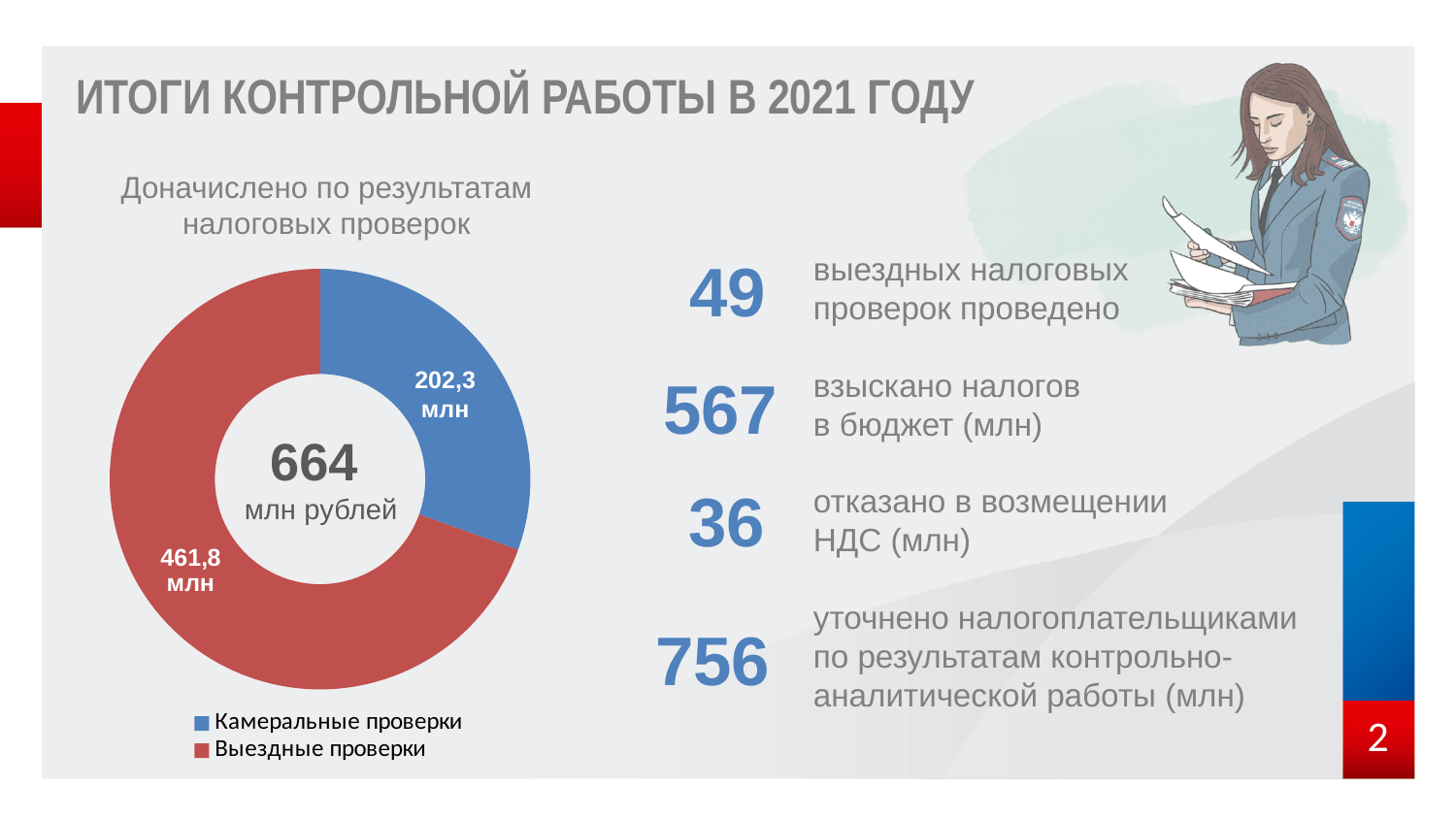
What colour represents Выездные проверки in the chart? Red What value is shown for Камеральные проверки in the chart? 202,3 млн What total is shown in the centre of the donut chart? 664 млн рублей Which is larger in the chart: Камеральные проверки or Выездные проверки? Выездные проверки How many entries does the chart legend list? 2 How many categories does the chart show? 2 Which category has the largest slice in the chart? Выездные проверки What is the title of the chart on the slide? Доначислено по результатам налоговых проверок What value is shown for Выездные проверки in the chart? 461,8 млн Which category has the smallest slice in the chart? Камеральные проверки What is the difference between Выездные проверки and Камеральные проверки in the chart? 259,5 млн What type of chart is shown on the slide? Pie (donut) chart